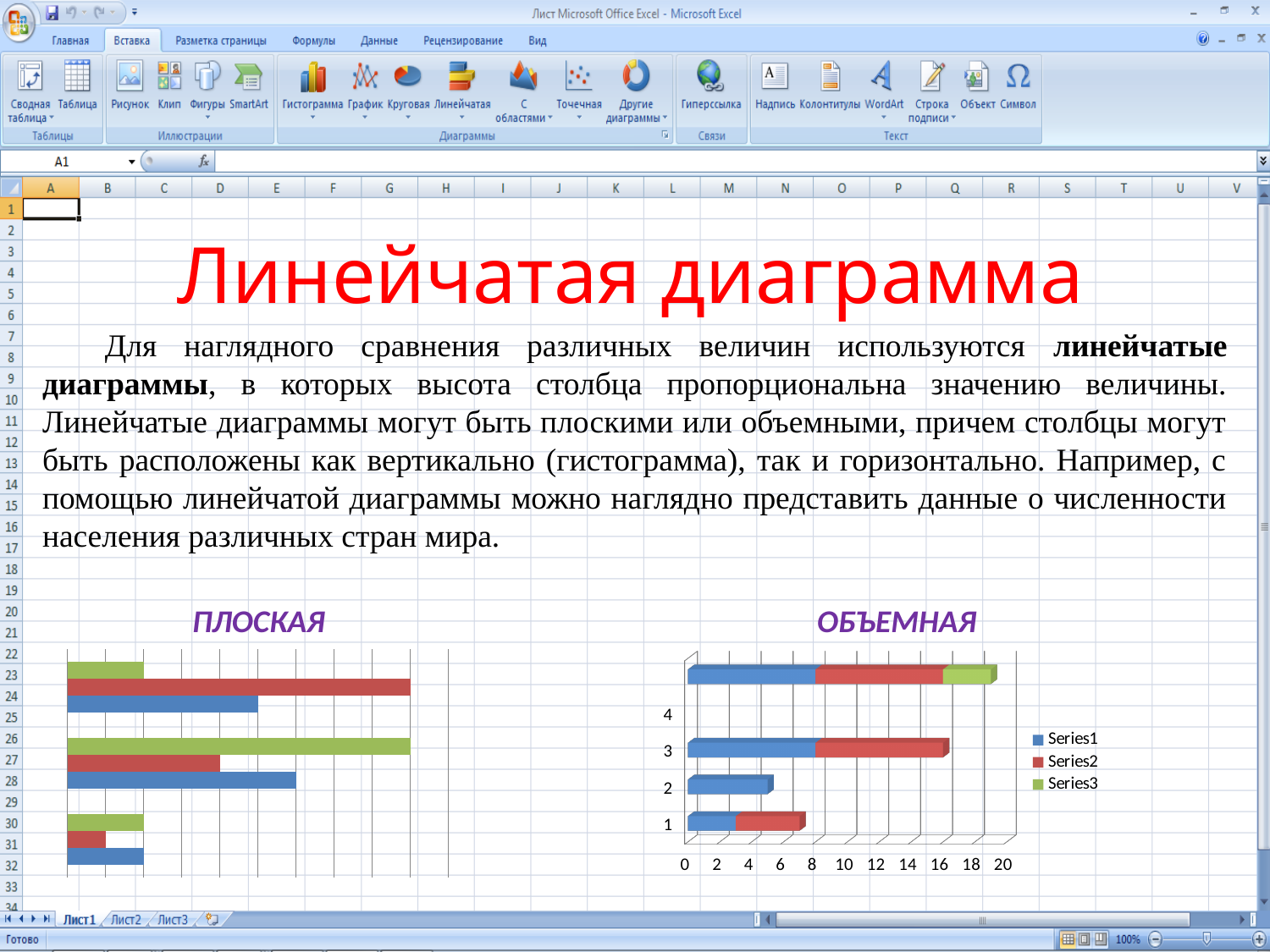
In the ОБЪЕМНАЯ chart, which stacked bar is longer, category 3 or category 1? category 3 In the ОБЪЕМНАЯ chart, is the total length of the bar for category 2 greater or less than 8? less What kind of chart is the ПЛОСКАЯ chart on the left? bar chart In the ОБЪЕМНАЯ chart, what is the highest value shown on the horizontal axis? 20 In the ОБЪЕМНАЯ chart, how many categories are shown on the vertical axis? 4 In the ОБЪЕМНАЯ chart, which category has the shortest stacked bar? 2 In the ОБЪЕМНАЯ chart, is the total length of the bar for category 1 greater or less than 10? less What kind of chart is the ОБЪЕМНАЯ chart on the right? bar chart In the ОБЪЕМНАЯ chart, how many series does the legend list? 3